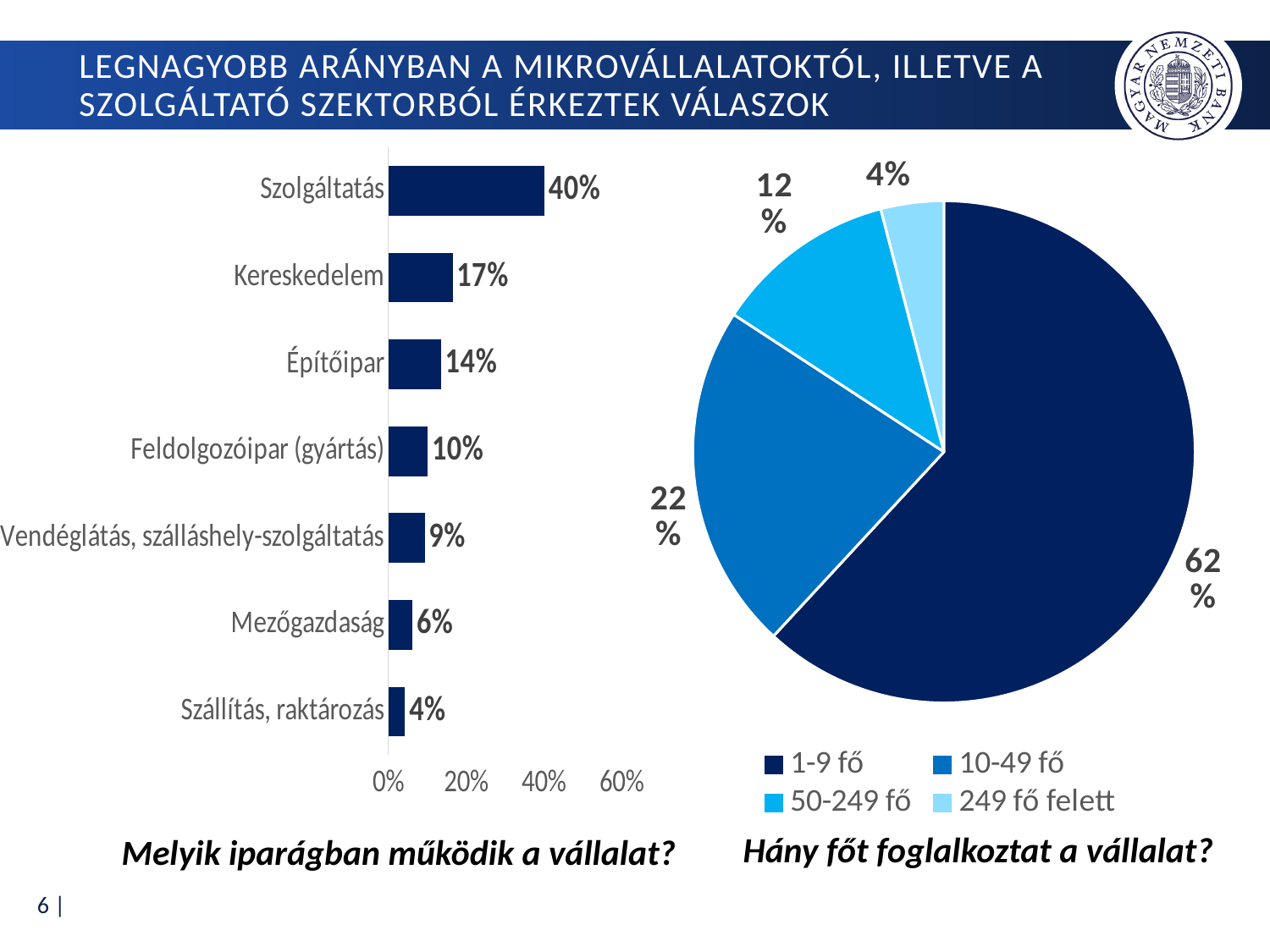
What kind of chart is the chart on the left? bar chart What question is written below the pie chart on the right? Hány főt foglalkoztat a vállalat? In the bar chart on the left, which category has the lowest value? Szállítás, raktározás In the pie chart on the right, what is the value for 50-249 fő? 12% In the bar chart on the left, what is the value for Szolgáltatás? 40% In the bar chart on the left, which is larger: Mezőgazdaság or Vendéglátás, szálláshely-szolgáltatás? Vendéglátás, szálláshely-szolgáltatás In the bar chart on the left, what is the difference between Kereskedelem and Feldolgozóipar (gyártás)? 7% How many entries does the legend of the pie chart on the right list? 4 How many categories does the bar chart on the left show? 7 In the bar chart on the left, which category has the highest value? Szolgáltatás In the bar chart on the left, what is the value for Építőipar? 14% In the pie chart on the right, what share does the 1-9 fő slice have? 62%